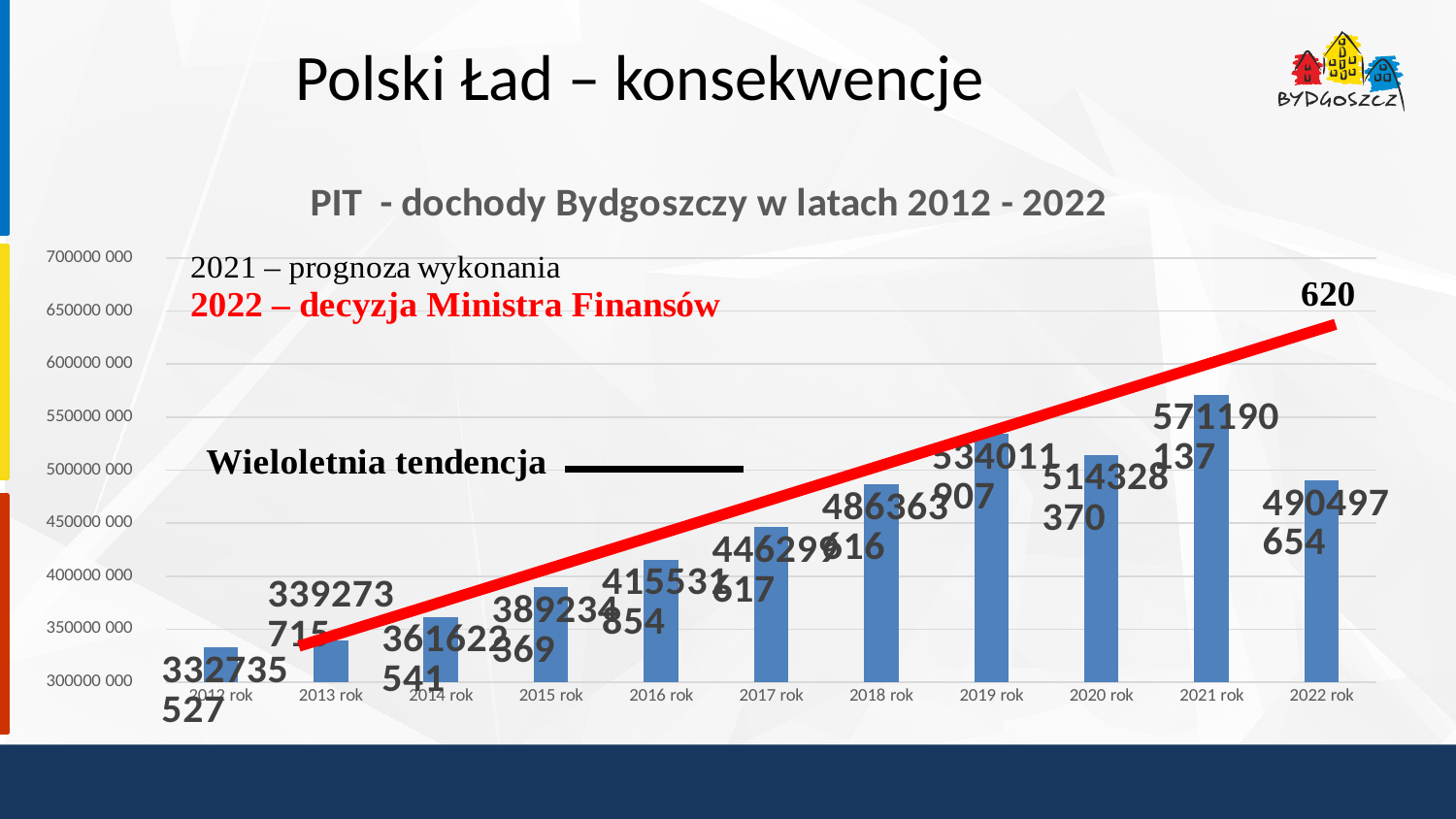
What label is given to the red line in the chart? Wieloletnia tendencja What is the value labelled for 2019 rok? 534011 907 What is the value labelled for 2022 rok? 490497 654 What is the value labelled for 2021 rok? 571190 137 Which is larger, the value for 2019 rok or for 2020 rok? 2019 rok Which year has the highest PIT income in the chart? 2021 rok Is the value for 2022 rok greater or less than 450000 000? greater Which year has the lowest PIT income in the chart? 2012 rok How many years (bars) are shown in the chart? 11 What is the title of the chart? PIT - dochody Bydgoszczy w latach 2012 - 2022 What type of chart is shown on the slide? bar chart Do the bar values generally rise or fall from 2012 rok to 2019 rok? rise